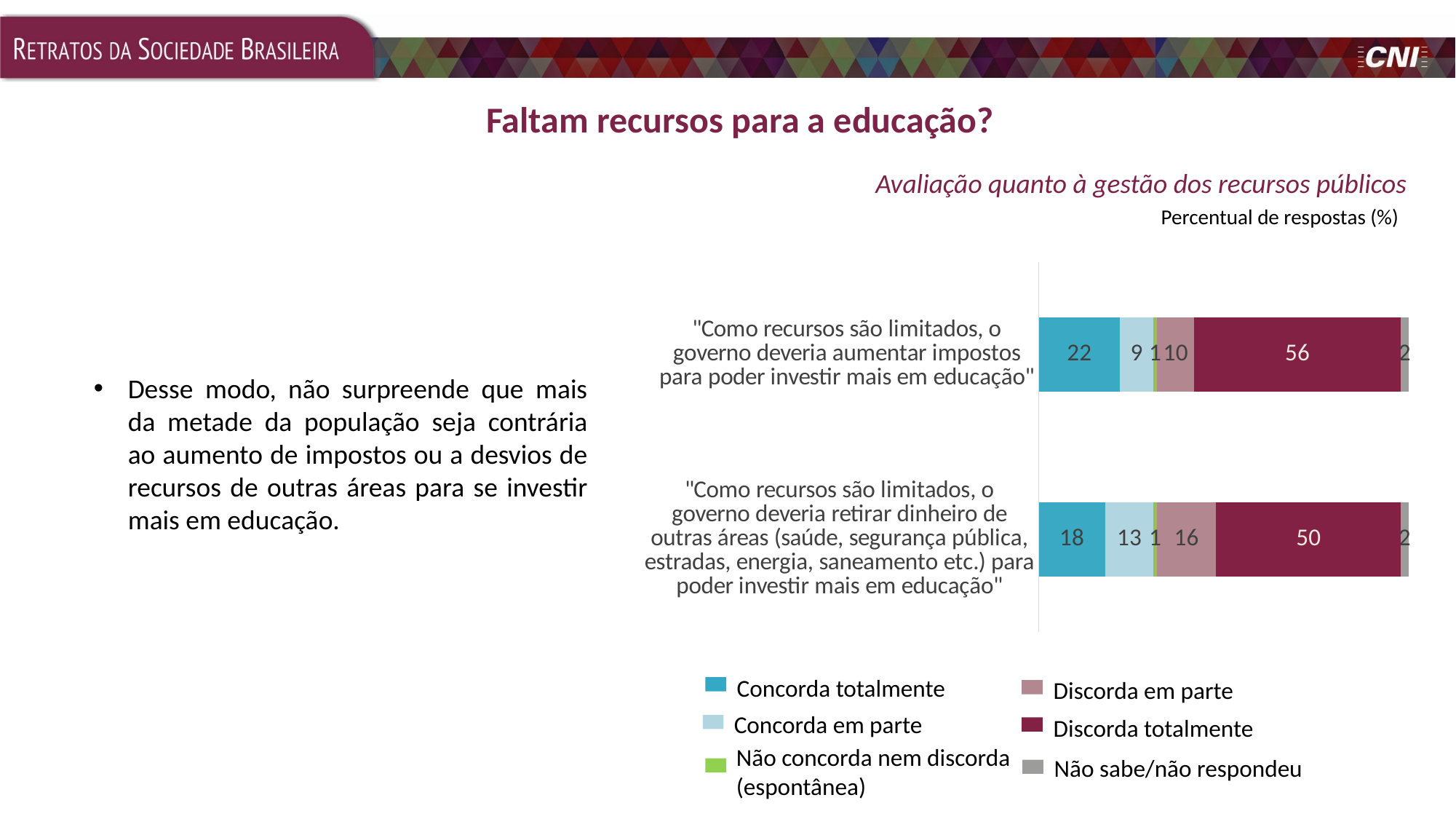
What is the difference between the 'Discorda totalmente' values for the two statements? 6 Which response category has the largest share for the statement about raising taxes to invest in education? Discorda totalmente What percentage of respondents 'Discorda totalmente' with the statement that the government should take money from other areas to invest more in education? 50 What is the 'Concorda em parte' value for the statement about raising taxes to invest more in education? 9 What percentage of respondents 'Concorda totalmente' with the statement that the government should raise taxes to invest more in education? 22 How many response categories does the legend list? 6 How many statements (bars) are shown in the chart? 2 What is the 'Discorda em parte' value for the statement about taking money from other areas (saúde, segurança pública, etc.)? 16 What is the subtitle of the chart? Avaliação quanto à gestão dos recursos públicos Which statement has a higher 'Concorda totalmente' value: raising taxes or taking money from other areas? Raising taxes (22) What is the total of the stacked bar for the statement about taking money from other areas to invest in education? 100 What type of chart is shown on the slide? Stacked bar chart